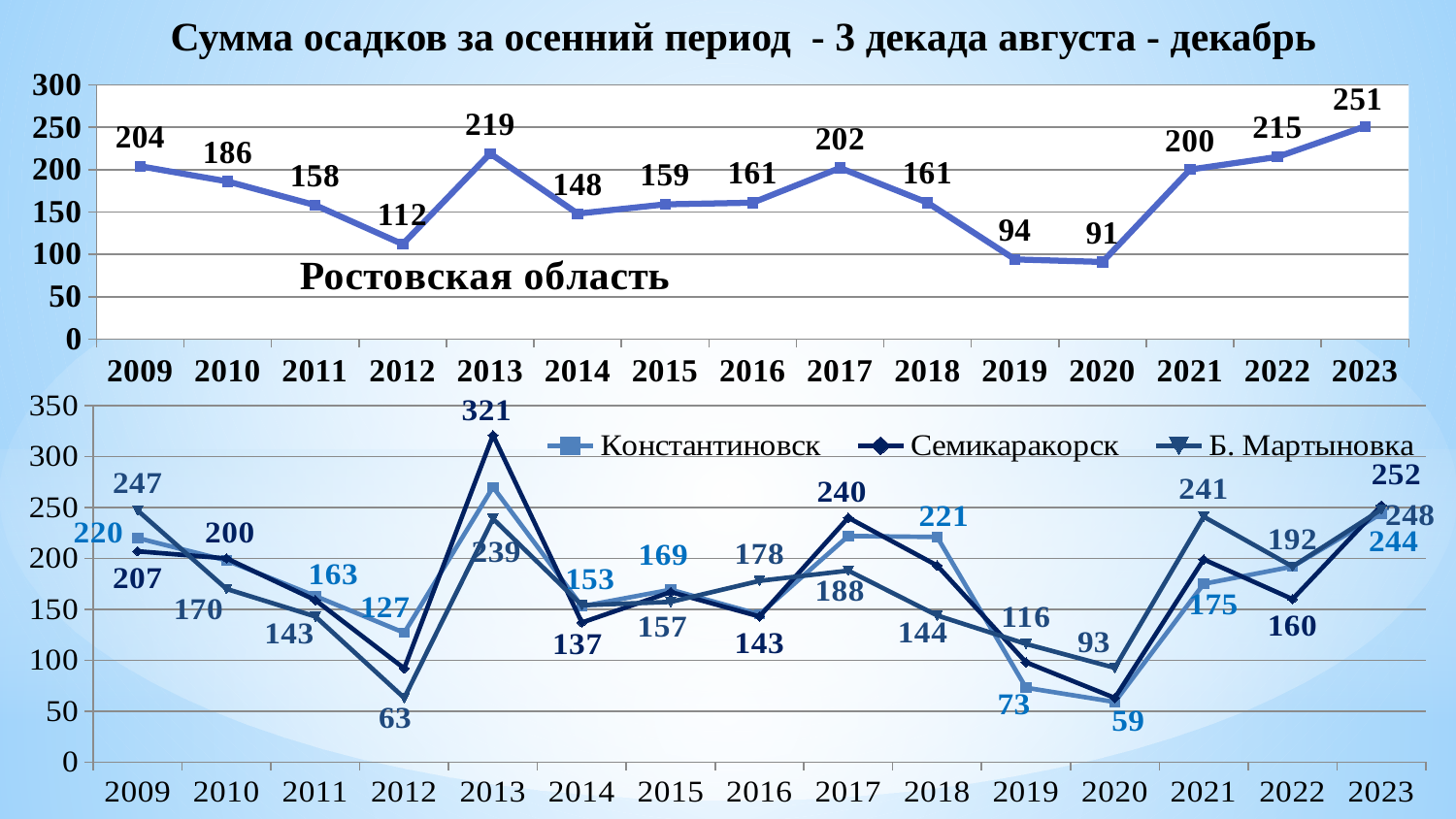
On the top chart (Ростовская область), what is the difference between the values for 2023 and 2020? 160 On the top chart (Ростовская область), what is the value for 2013? 219 On the top chart (Ростовская область), which year has the highest value? 2023 On the top chart (Ростовская область), which year has the lowest value? 2020 On the top chart (Ростовская область), how many years are plotted on the x axis? 15 On the bottom chart, what is the value for Константиновск in 2020? 59 On the bottom chart, what is the value for Б. Мартыновка in 2012? 63 On the top chart (Ростовская область), do the values rise or fall from 2020 to 2023? rise On the bottom chart, how many series does the legend list? 3 What kind of chart is the top chart (Ростовская область)? line chart On the bottom chart, what is the highest value shown for Семикаракорск? 321 On the top chart (Ростовская область), which is larger, the value for 2009 or the value for 2017? 2009